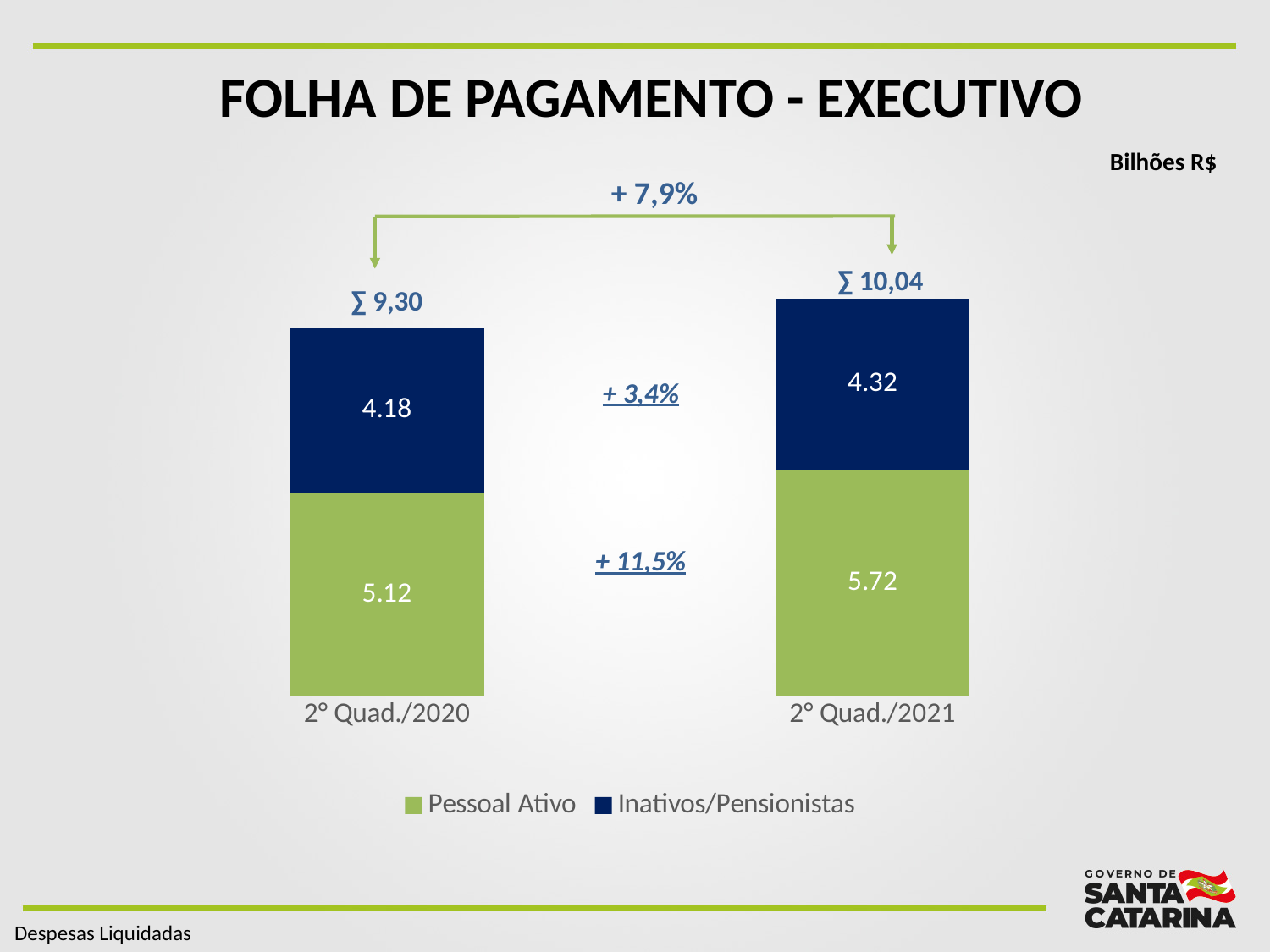
Which period has the higher total payroll? 2° Quad./2021 What is the total shown above the stacked bar for 2° Quad./2020? ∑ 9,30 What kind of chart is shown on the slide? Stacked bar chart What is the value for Inativos/Pensionistas in 2° Quad./2020? 4.18 What is the value for Pessoal Ativo in 2° Quad./2021? 5.72 What is the total shown above the stacked bar for 2° Quad./2021? ∑ 10,04 What is the value for Inativos/Pensionistas in 2° Quad./2021? 4.32 Which is larger in 2° Quad./2021: Pessoal Ativo or Inativos/Pensionistas? Pessoal Ativo How many series does the legend list? 2 What is the difference between the Pessoal Ativo values for 2° Quad./2021 and 2° Quad./2020? 0.60 What percentage change is shown between the two totals at the top of the chart? + 7,9% What is the value for Pessoal Ativo in 2° Quad./2020? 5.12